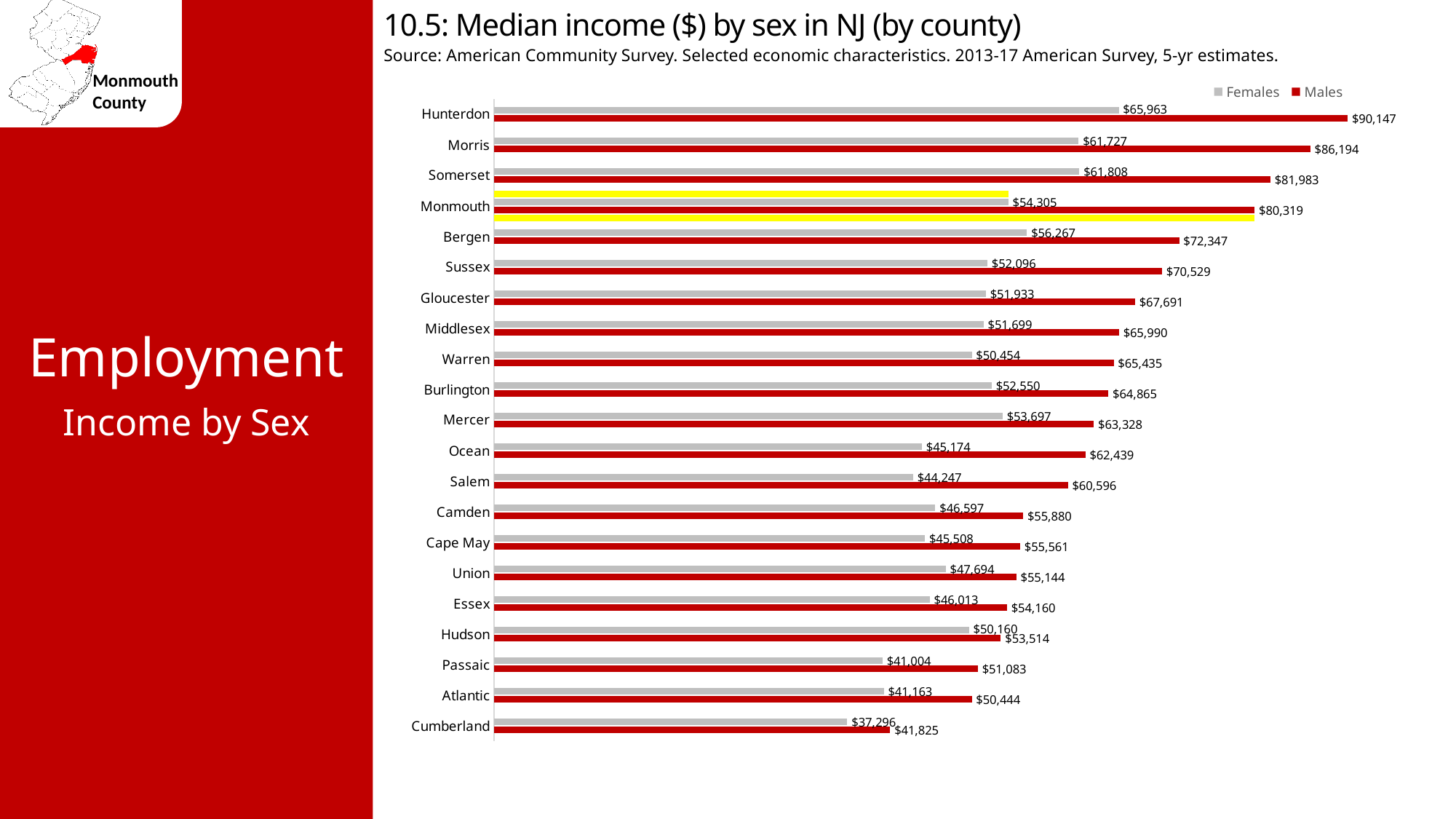
Which is larger, the female median income in Bergen County or in Monmouth County? Bergen County Which county has the highest median income for males? Hunterdon What is the difference between male and female median income in Monmouth County? $26,014 What is the median income for females in Monmouth County? $54,305 Which county has the lowest median income for females? Cumberland What is the median income for males in Monmouth County? $80,319 How many series does the legend list? 2 How many counties are shown in the chart? 21 What is the median income for females in Cumberland County? $37,296 Which colour represents Males in the chart? Red What type of chart is shown on the slide? Bar chart What is the median income for males in Hunterdon County? $90,147